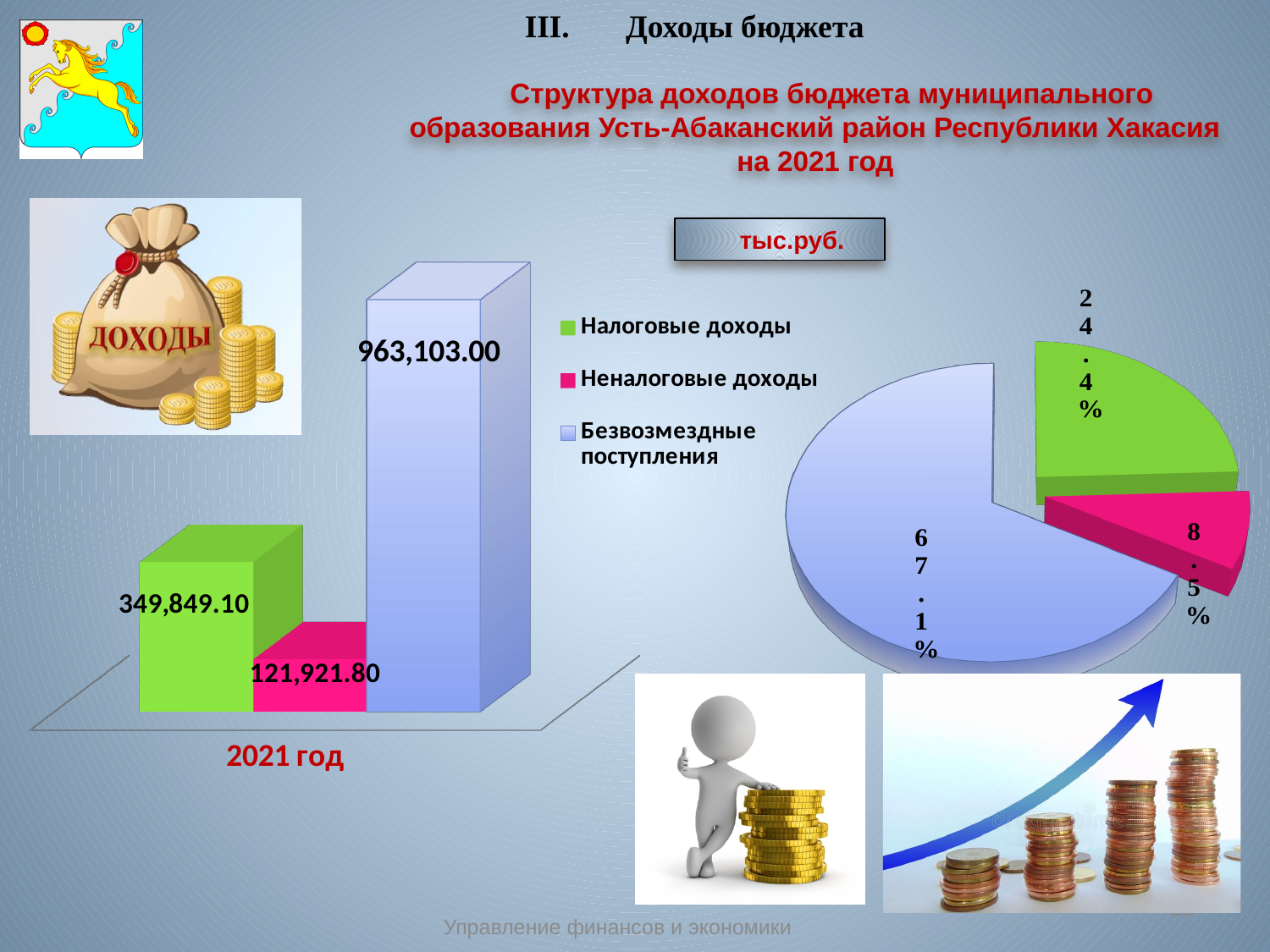
What kind of chart is the chart on the left of the slide? Bar chart On the pie chart on the right, what share does the light blue slice (Безвозмездные поступления) have? 67.1% On the bar chart on the left, which category has the highest value? Безвозмездные поступления What unit is shown in the box above the charts? тыс.руб. On the bar chart on the left, what is the value for Неналоговые доходы in 2021? 121,921.80 On the bar chart on the left, what is the value for Налоговые доходы in 2021? 349,849.10 On the pie chart on the right, what share does the green slice (Налоговые доходы) have? 24.4% On the bar chart on the left, which category has the lowest value? Неналоговые доходы How many series does the legend list? 3 On the bar chart on the left, which is larger: Налоговые доходы or Неналоговые доходы? Налоговые доходы On the bar chart on the left, what is the value for Безвозмездные поступления in 2021? 963,103.00 On the bar chart on the left, what is the difference between Безвозмездные поступления and Налоговые доходы? 613,253.90